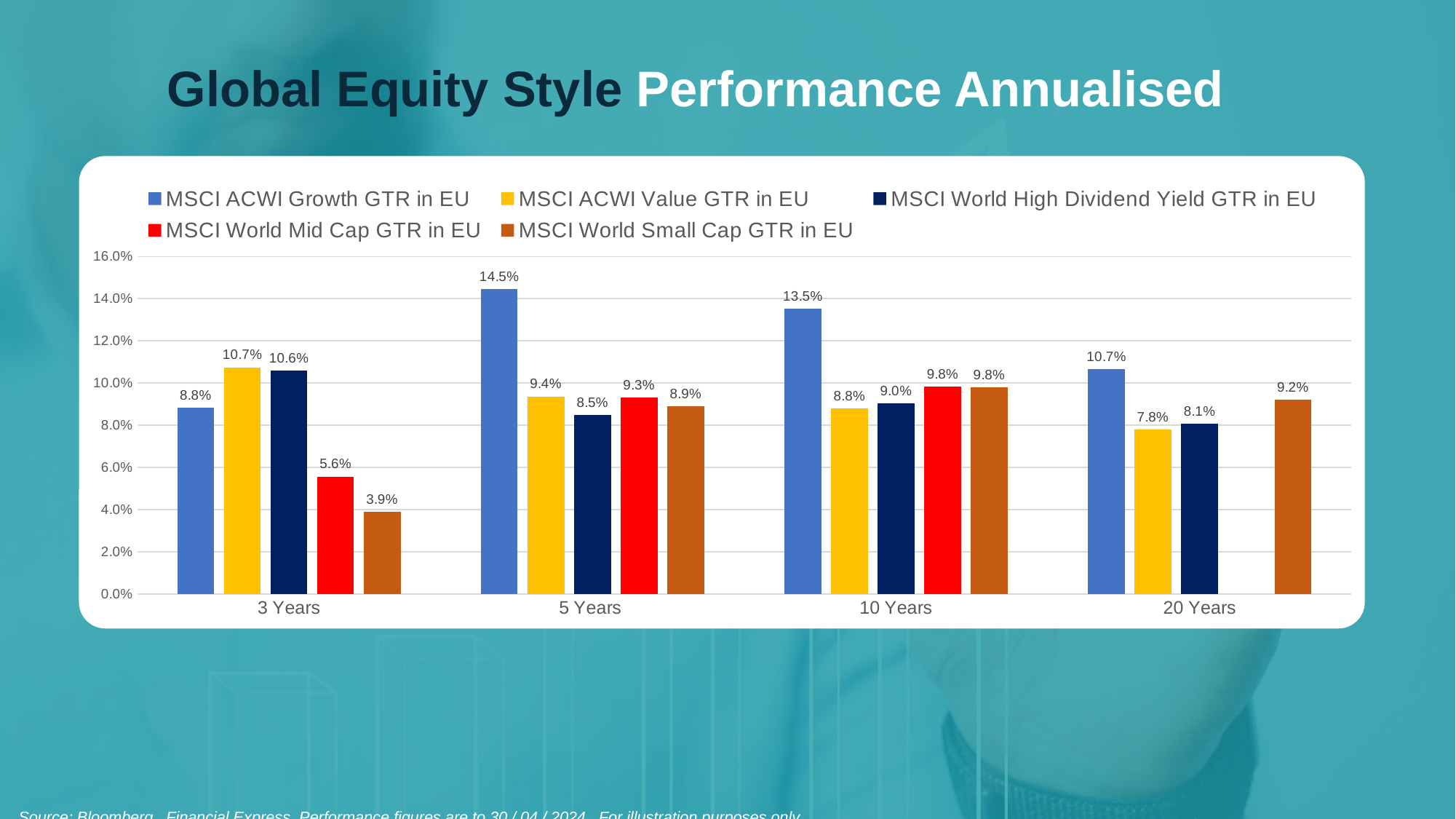
What is the value for MSCI World Small Cap GTR in EU at 3 Years? 3.9% What kind of chart is shown on the slide? Bar chart Which series has the lowest value at 5 Years? MSCI World High Dividend Yield GTR in EU What is the value for MSCI ACWI Growth GTR in EU at 5 Years? 14.5% Is the value for MSCI ACWI Growth GTR in EU at 10 Years greater or less than 12.0%? greater What is the value for MSCI World Mid Cap GTR in EU at 10 Years? 9.8% Which series has the highest value at 3 Years? MSCI ACWI Value GTR in EU What is the value for MSCI ACWI Value GTR in EU at 20 Years? 7.8% How many series does the legend list? 5 What is the difference between MSCI ACWI Growth GTR in EU and MSCI ACWI Value GTR in EU at 10 Years? 4.7% How many time-period categories are shown on the x axis? 4 Which is larger at 20 Years: MSCI World High Dividend Yield GTR in EU or MSCI World Small Cap GTR in EU? MSCI World Small Cap GTR in EU